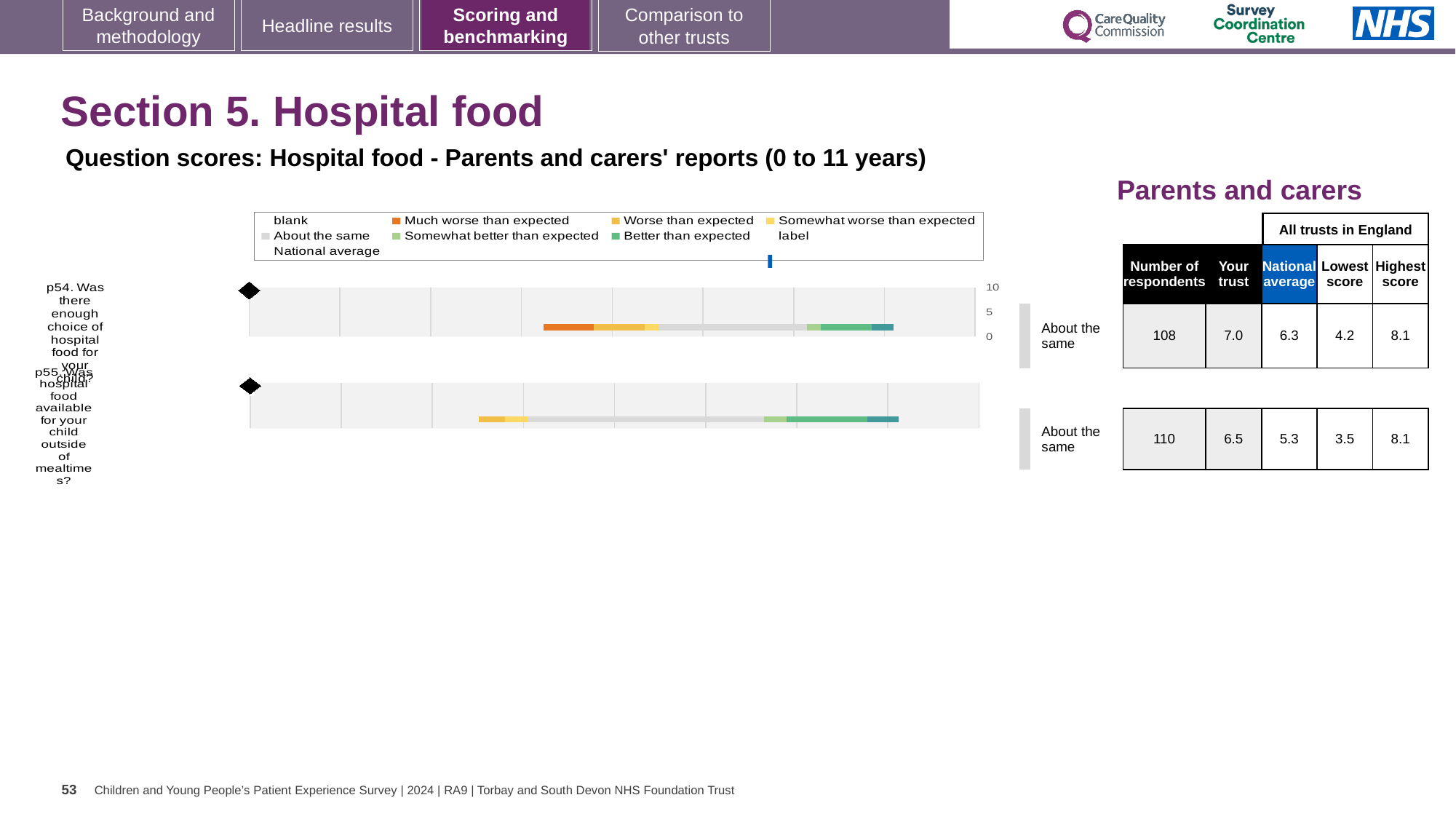
How many questions (bars) are plotted in the hospital food chart? 2 How many respondents answered p54? 108 What is the lowest score among all trusts in England for p55? 3.5 What is the highest value shown on the chart's score axis? 10 For p54, is the 'Your trust' score higher or lower than the national average? higher What is the national average score for p55 (hospital food available outside of mealtimes)? 5.3 What benchmark category is shown for p54? About the same Which question had more respondents, p54 or p55? p55 What kind of chart is used to show the question scores for hospital food? bar chart What is the 'Your trust' score for p54 (enough choice of hospital food for your child)? 7.0 Which colour does the legend use for 'Much worse than expected'? orange What is the difference between the 'Your trust' score and the national average for p55? 1.2